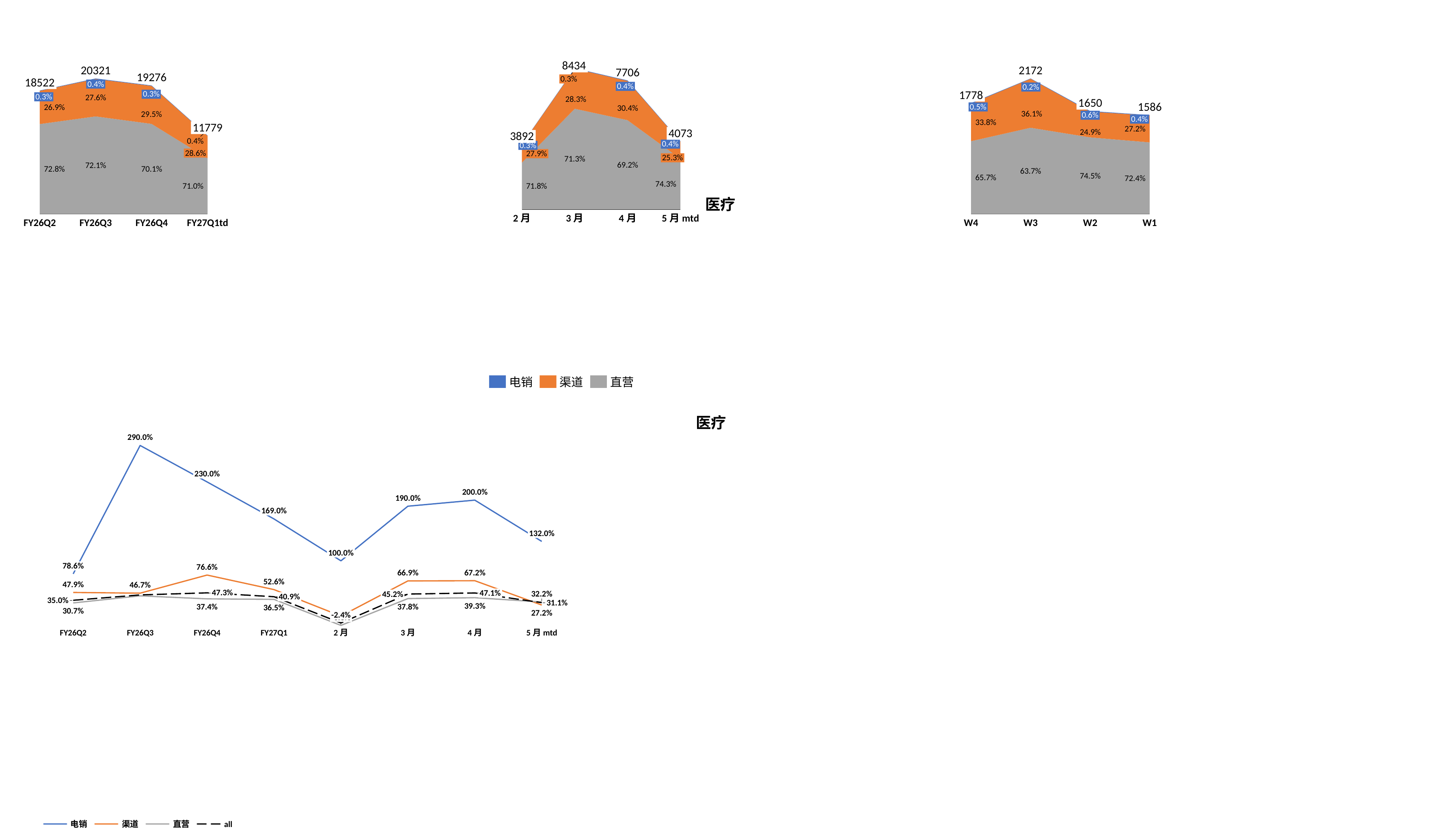
In the top-middle chart (2月 to 5月 mtd), what share does 渠道 have in 5月 mtd? 25.3% In the top-left chart (FY26Q2 to FY27Q1td), what share does 直营 have in FY26Q4? 70.1% In the top-right chart (W4 to W1), is the total for W2 larger or smaller than the total for W1? larger In the bottom line chart titled 医疗, how many series does the legend list? 4 In the bottom line chart titled 医疗, what is the 渠道 value at FY26Q4? 76.6% In the top-right chart (W4 to W1), what share does 渠道 have in W2? 24.9% In the top-right chart (W4 to W1), which week has the highest total? W3 In the top-middle chart (2月 to 5月 mtd), what is the total value for 3月? 8434 In the bottom line chart titled 医疗, what is the 电销 value at FY26Q3? 290.0% In the top-middle chart (2月 to 5月 mtd), what is the difference between the totals for 3月 and 4月? 728 In the top-left chart (FY26Q2 to FY27Q1td), what is the total value shown for FY26Q3? 20321 In the top-left chart (FY26Q2 to FY27Q1td), which period has the lowest total? FY27Q1td